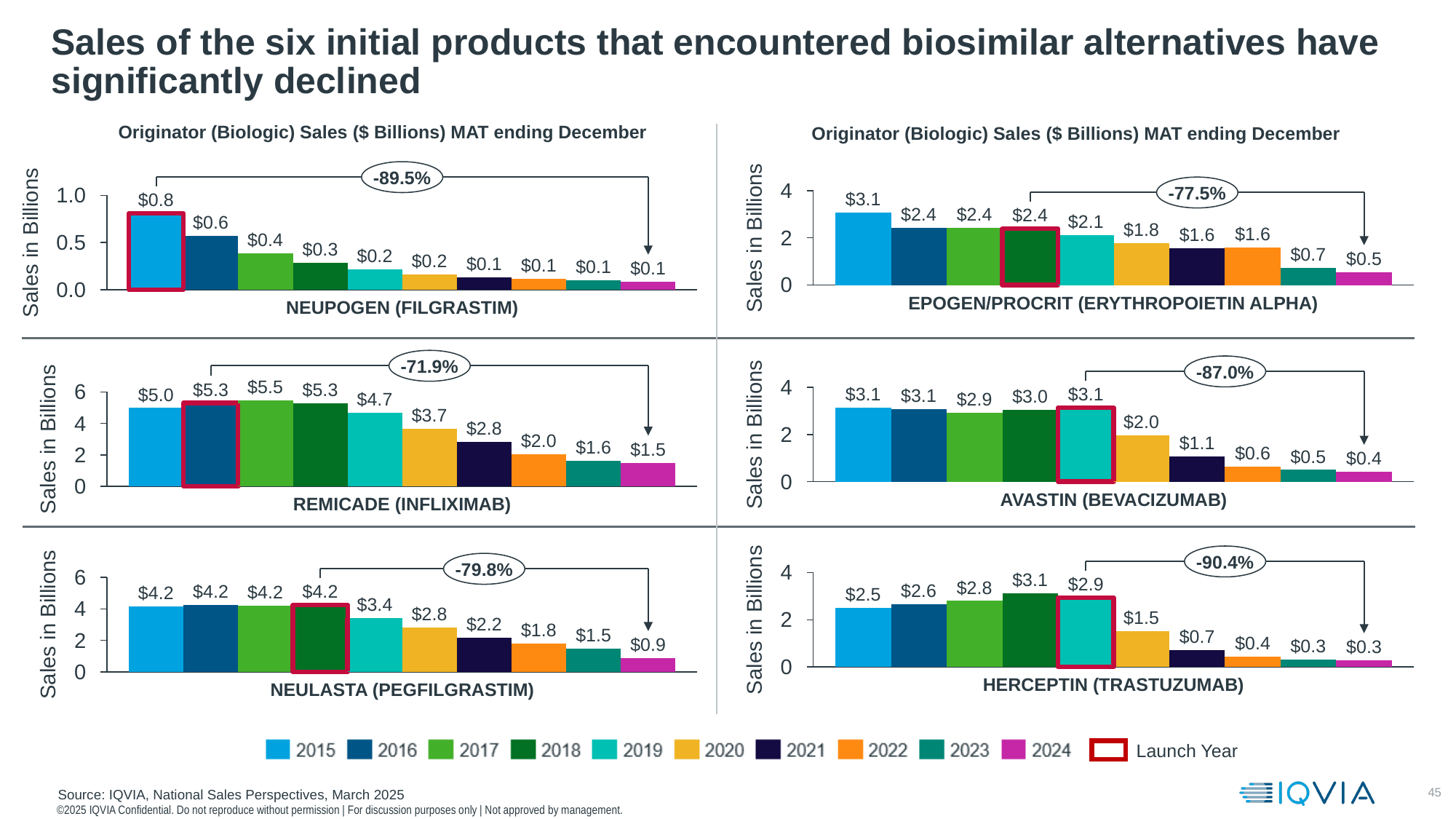
In the NEUPOGEN (FILGRASTIM) chart, do sales rise or fall from 2015 to 2024? Fall In the REMICADE (INFLIXIMAB) chart, which year had the highest sales? 2017 In the REMICADE (INFLIXIMAB) chart, what were sales in 2017? $5.5 In the EPOGEN/PROCRIT (ERYTHROPOIETIN ALPHA) chart, which year had the lowest sales? 2024 In the NEULASTA (PEGFILGRASTIM) chart, which is larger, sales in 2019 or sales in 2020? 2019 How many years (bars) are shown in the HERCEPTIN (TRASTUZUMAB) chart? 10 What percentage decline is labelled on the HERCEPTIN (TRASTUZUMAB) chart? -90.4% In the HERCEPTIN (TRASTUZUMAB) chart, what were sales in 2018? $3.1 What type of chart is used for the AVASTIN (BEVACIZUMAB) data? Bar chart How many years does the shared legend at the bottom of the slide list? 10 In the AVASTIN (BEVACIZUMAB) chart, what is the difference between 2019 sales and 2020 sales? $1.1 In the NEUPOGEN (FILGRASTIM) chart, what were sales in 2015? $0.8